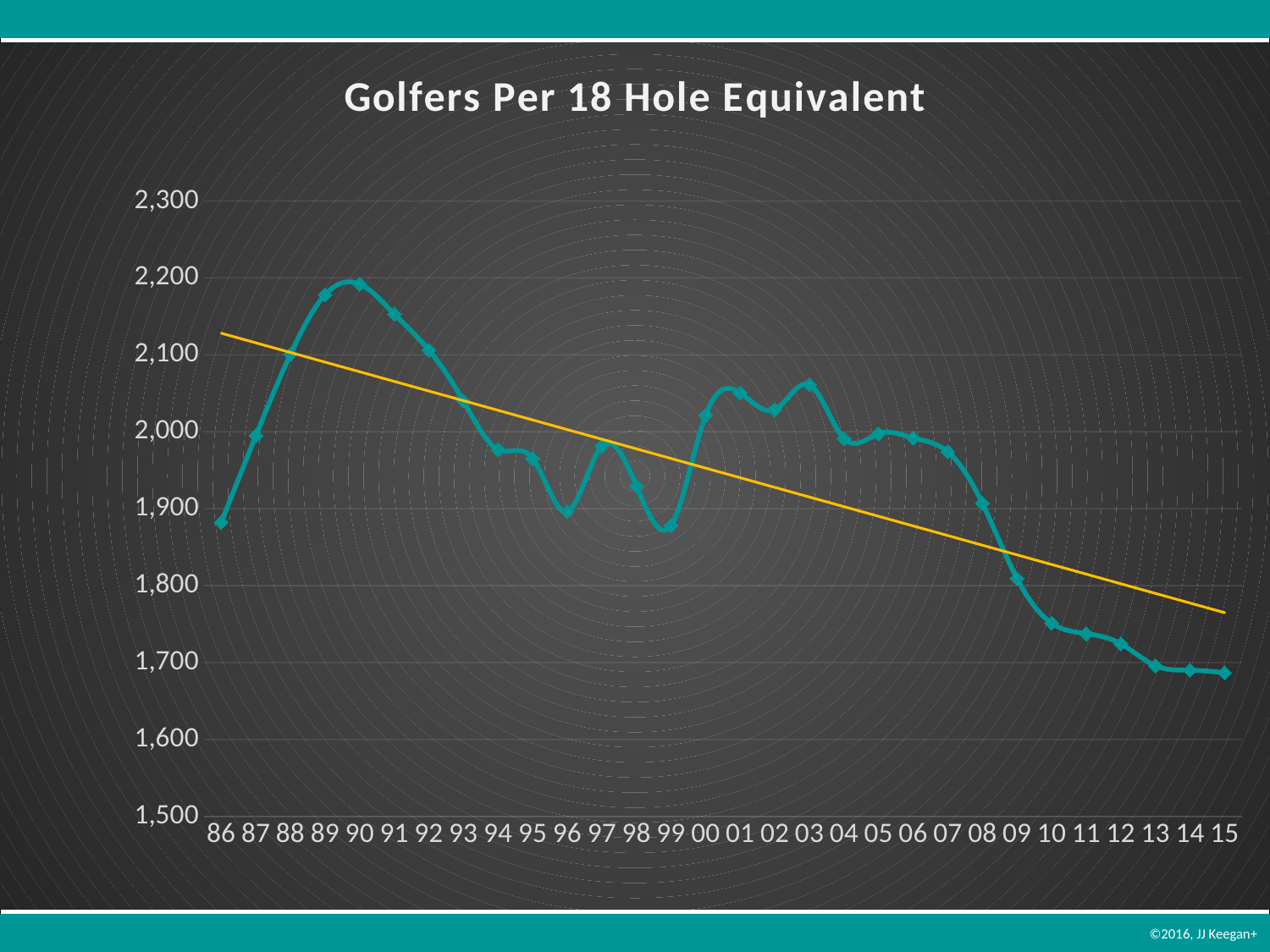
Is the value for 15 greater or less than 1,700? less Is the value for 10 greater or less than 1,800? less Is the value for 90 greater or less than 2,100? greater Overall, do the values rise or fall from 86 to 15? fall Which is larger, the value for 03 or the value for 09? 03 Which is larger, the value for 86 or the value for 92? 92 What is the title of the chart? Golfers Per 18 Hole Equivalent How many years are plotted along the x axis? 30 Which year has the highest value? 90 What kind of chart is shown on the slide? line chart